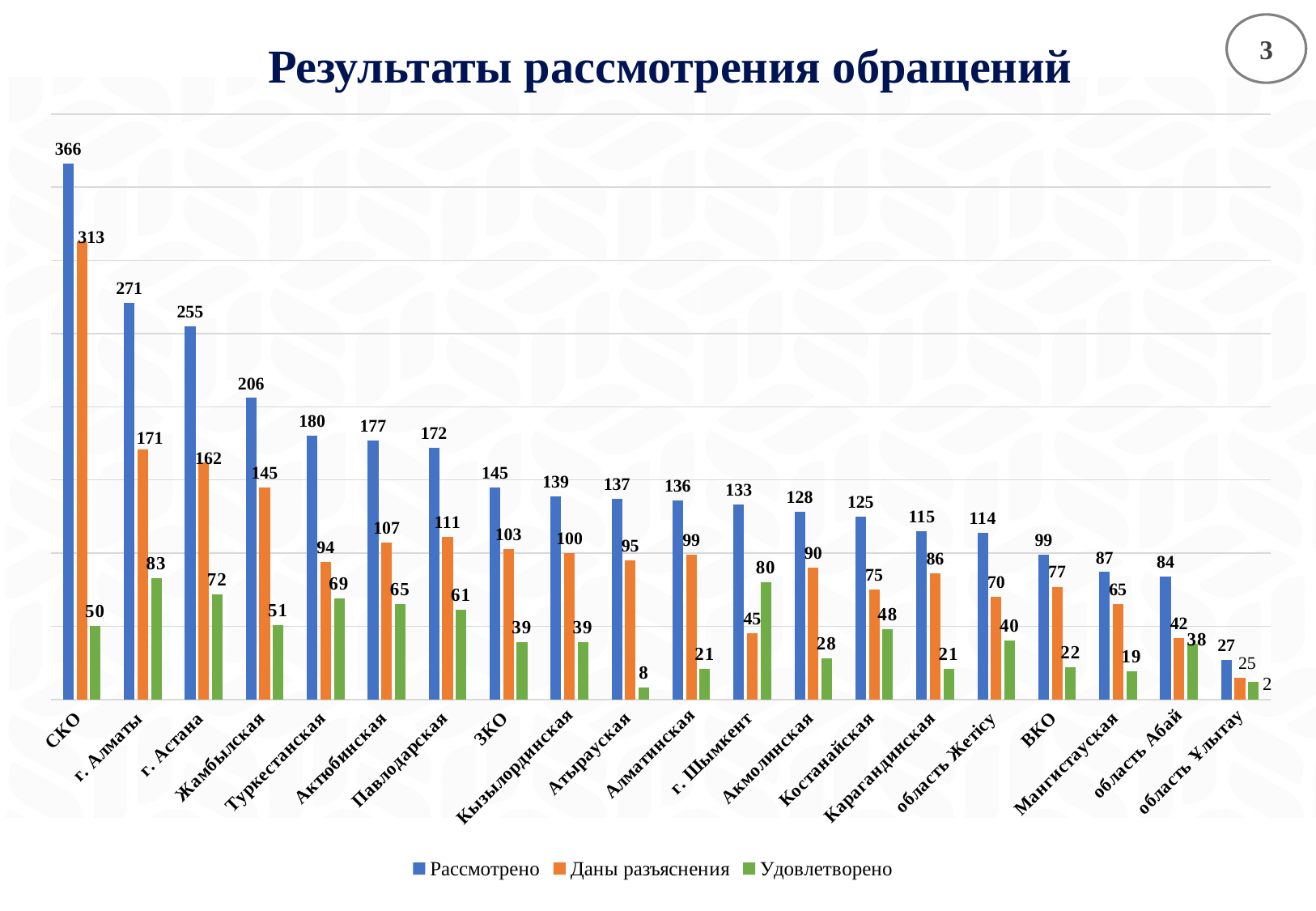
Which region has the highest value of Рассмотрено? СКО Which is larger for Атырауская: Даны разъяснения or Удовлетворено? Даны разъяснения Do the Рассмотрено values rise or fall from left to right along the x axis? Fall What is the value of Удовлетворено for г. Шымкент? 80 How many regions are shown on the x axis? 20 What is the value of Даны разъяснения for г. Астана? 162 Which region has the lowest value of Удовлетворено? область Ұлытау What kind of chart is shown on the slide? Bar chart What is the title of the chart? Результаты рассмотрения обращений What is the value of Рассмотрено for СКО? 366 What is the difference between Рассмотрено and Даны разъяснения for г. Алматы? 100 How many series does the legend list? 3